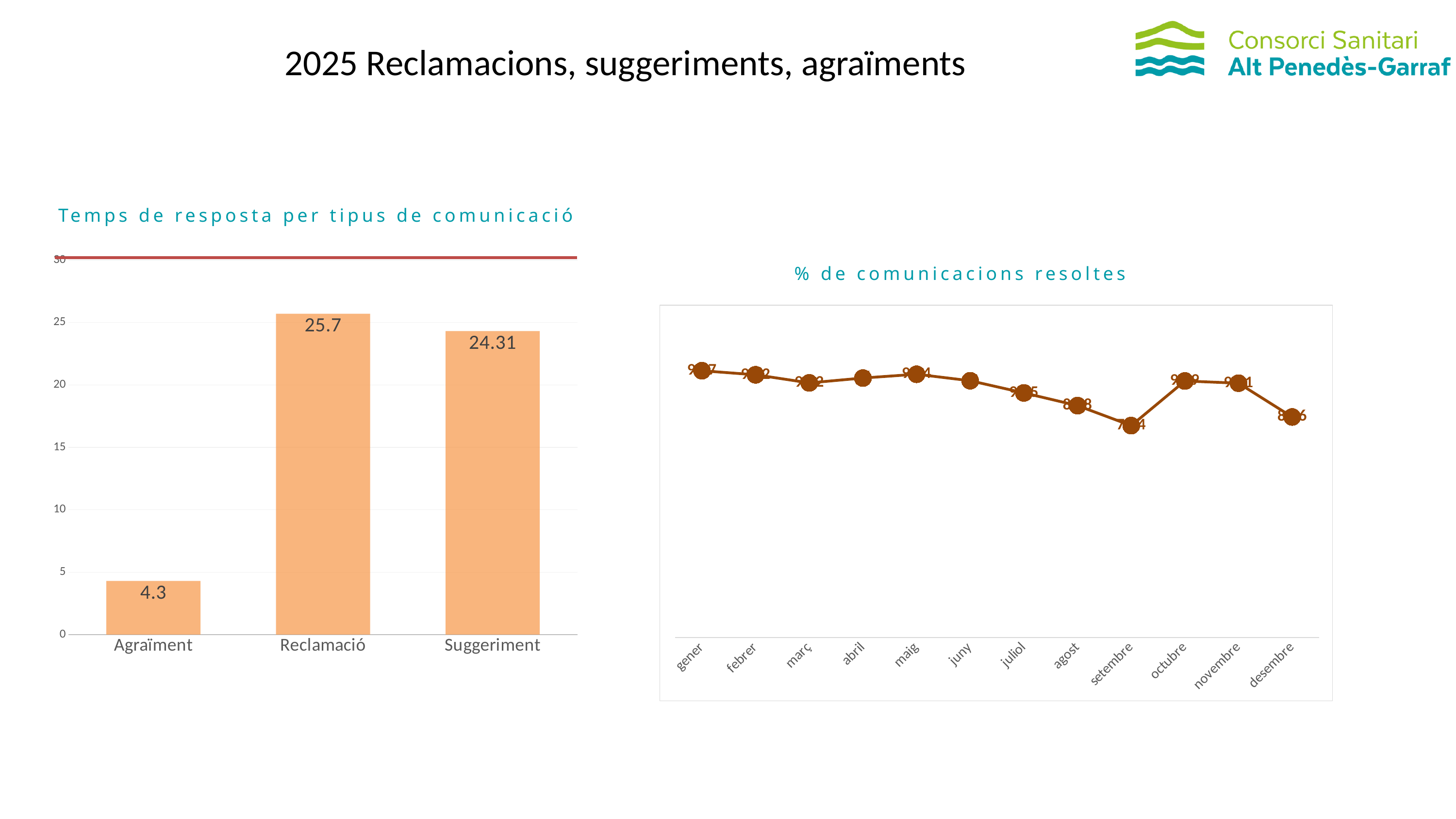
In the chart titled "Temps de resposta per tipus de comunicació", what is the value for Agraïment? 4.3 In the chart titled "Temps de resposta per tipus de comunicació", which is larger, the value for Reclamació or the value for Suggeriment? Reclamació In the chart titled "Temps de resposta per tipus de comunicació", what is the difference between the values for Reclamació and Agraïment? 21.4 In the chart titled "Temps de resposta per tipus de comunicació", which category has the lowest value? Agraïment In the chart titled "Temps de resposta per tipus de comunicació", what is the value for Reclamació? 25.7 In the chart titled "Temps de resposta per tipus de comunicació", how many categories are shown? 3 What kind of chart is the chart titled "% de comunicacions resoltes"? Line chart In the chart titled "% de comunicacions resoltes", which month has the lowest point on the line? setembre What kind of chart is the chart titled "Temps de resposta per tipus de comunicació"? Bar chart In the chart titled "Temps de resposta per tipus de comunicació", what is the value for Suggeriment? 24.31 In the chart titled "Temps de resposta per tipus de comunicació", which category has the highest value? Reclamació In the chart titled "% de comunicacions resoltes", how many months are plotted along the x axis? 12